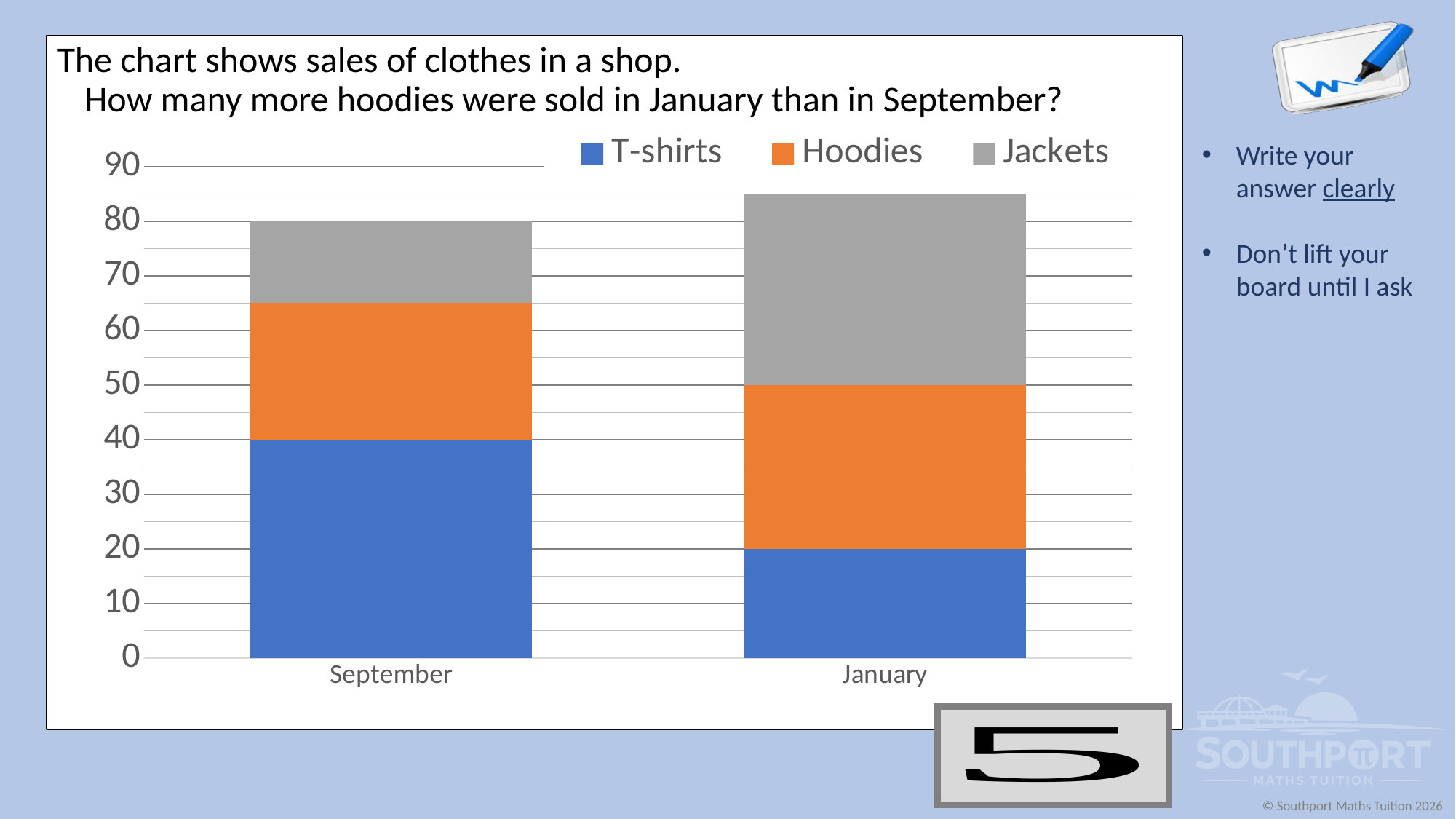
What is the total height of the September stacked bar? 80 Which month had more T-shirt sales, September or January? September How many T-shirts were sold in September? 40 Is the total height of the January stacked bar greater or less than 80? greater How many hoodies were sold in January? 30 Which month had more jacket sales, September or January? January What kind of chart is shown on the slide? stacked bar chart How many series does the legend list? 3 How many T-shirts were sold in January? 20 How many categories are shown on the x axis? 2 Which colour represents Hoodies in the legend? orange How many more T-shirts were sold in September than in January? 20